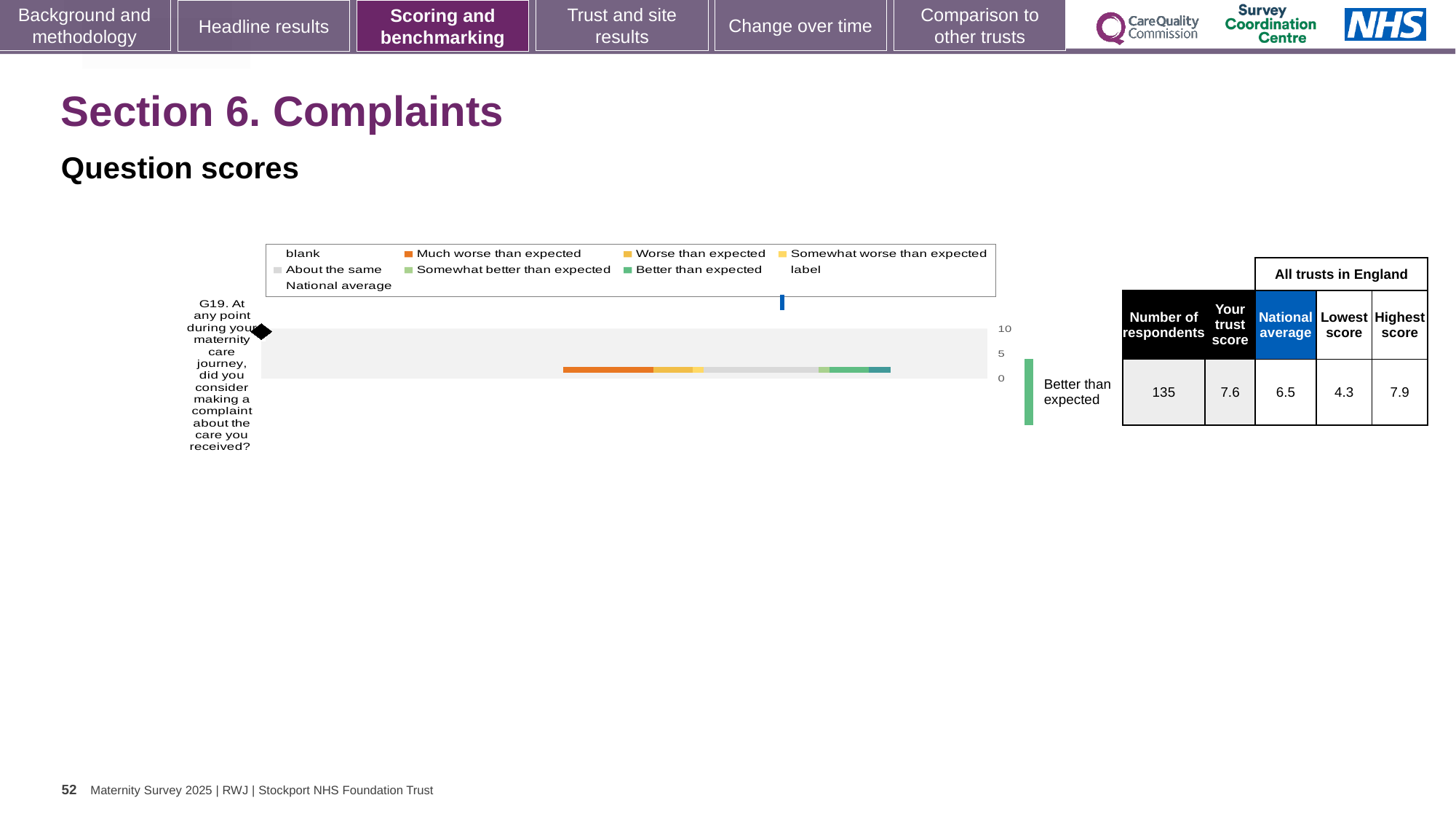
What is the difference between the trust score and the national average for G19? 1.1 What is the trust score for G19? 7.6 Which survey question is plotted in the chart? G19. At any point during your maternity care journey, did you consider making a complaint about the care you received? Which is larger for G19, the trust score or the national average? the trust score How many survey questions are plotted in the chart? 1 What is the national average score for G19? 6.5 Which benchmark category label is shown to the right of the chart for G19? Better than expected What is the difference between the highest score and the lowest score for G19? 3.6 How many respondents answered G19? 135 What is the lowest score among all trusts in England for G19? 4.3 What kind of chart is shown on the slide? bar chart What is the highest score among all trusts in England for G19? 7.9